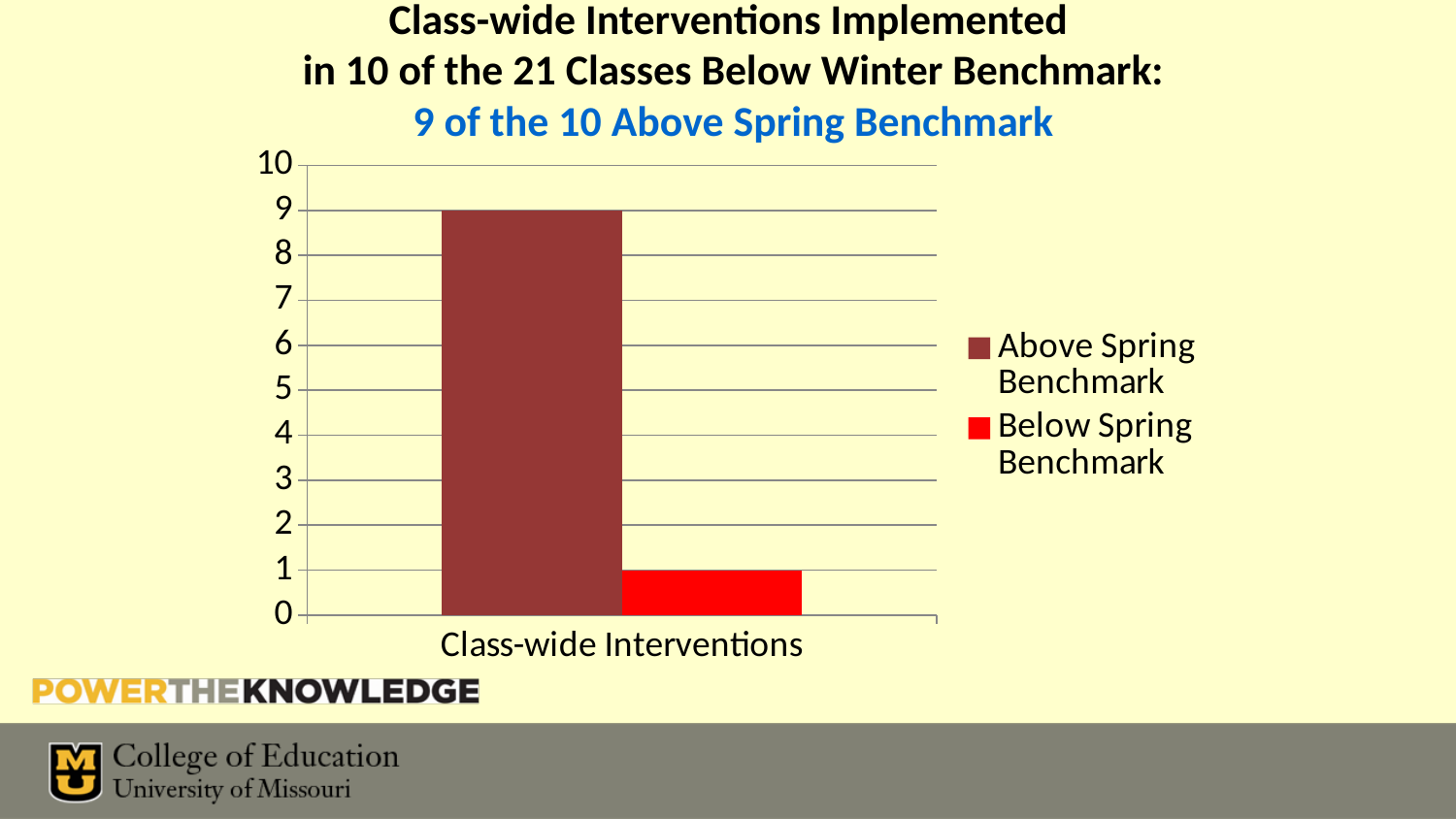
Which series has the lowest value? Below Spring Benchmark How many categories are shown on the x axis? 1 Is the value for Below Spring Benchmark greater or less than 5? less What is the highest value shown on the y axis? 10 What is the value for Above Spring Benchmark? 9 What is the label of the category on the x axis? Class-wide Interventions How many series does the legend list? 2 What kind of chart is shown on the slide? bar chart Which series has the higher value, Above Spring Benchmark or Below Spring Benchmark? Above Spring Benchmark Is the value for Above Spring Benchmark greater or less than 5? greater What is the value for Below Spring Benchmark? 1 What is the difference between the Above Spring Benchmark and Below Spring Benchmark values? 8